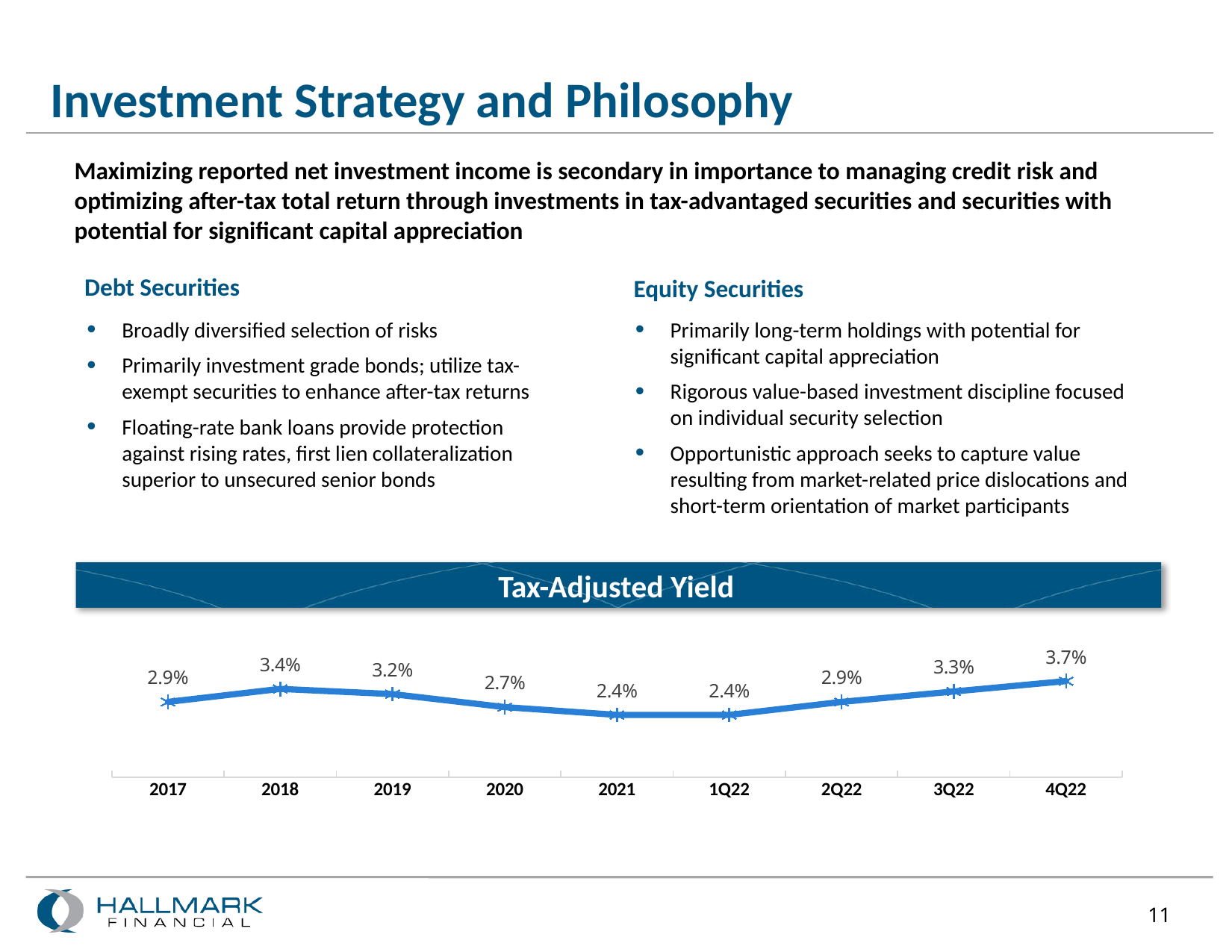
Does the tax-adjusted yield rise or fall from 1Q22 to 4Q22? Rise Which is larger, the tax-adjusted yield for 2019 or for 2020? 2019 What is the title of the chart on the slide? Tax-Adjusted Yield What is the tax-adjusted yield for 4Q22? 3.7% How many periods are plotted on the Tax-Adjusted Yield chart? 9 What is the difference between the tax-adjusted yield in 2018 and in 2017? 0.5% What is the tax-adjusted yield for 2018? 3.4% What is the difference between the tax-adjusted yield in 4Q22 and in 2021? 1.3% What is the lowest tax-adjusted yield shown on the chart? 2.4% Which period has the highest tax-adjusted yield? 4Q22 What kind of chart is the Tax-Adjusted Yield chart? Line chart What is the tax-adjusted yield for 2021? 2.4%